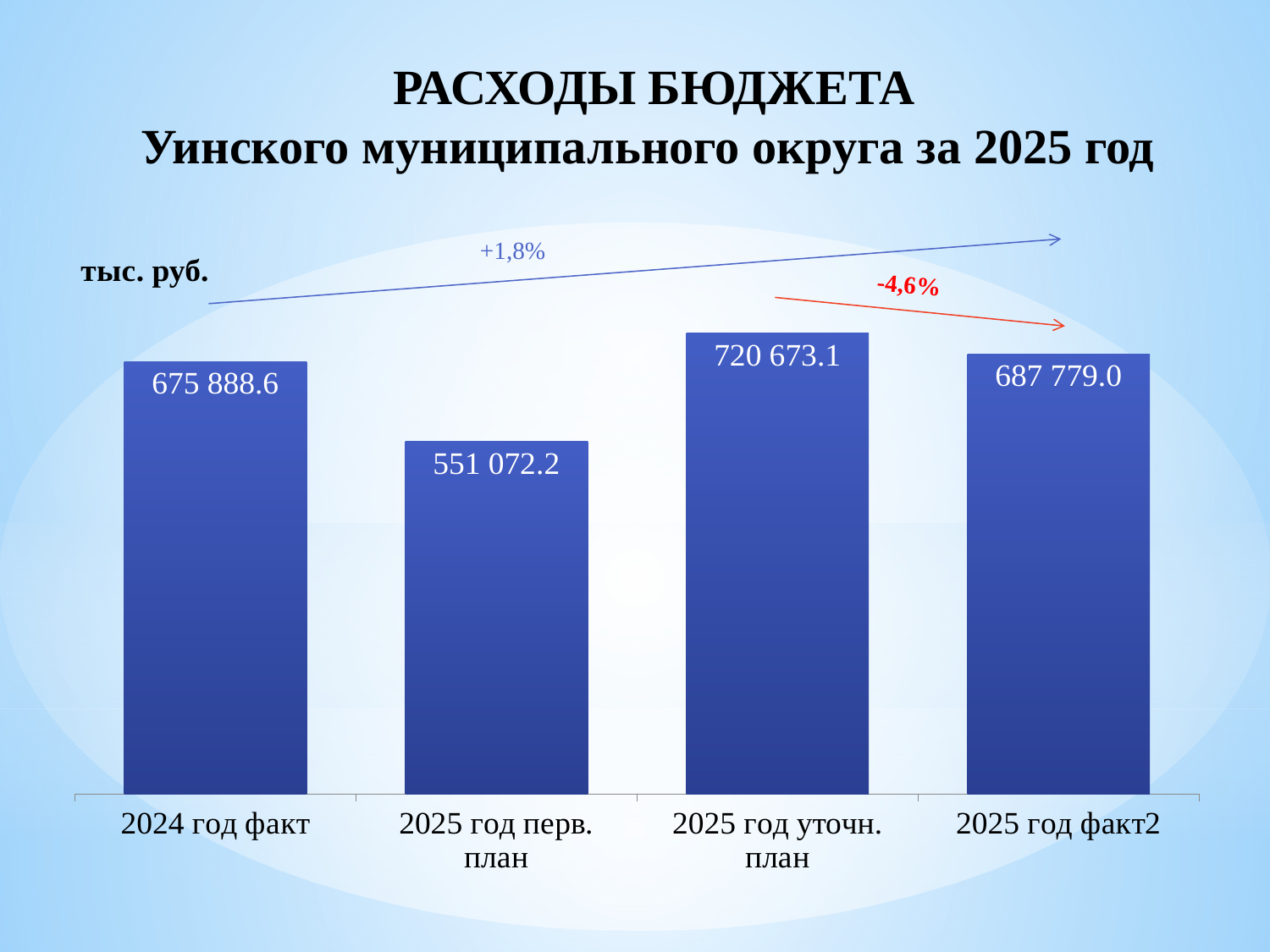
Which is larger, the value for 2024 год факт or the value for 2025 год факт2? 2025 год факт2 What unit of measurement is indicated for the chart values? тыс. руб. Which category has the lowest value? 2025 год перв. план What is the difference between the values for 2025 год уточн. план and 2025 год факт2? 32 894.1 How many categories are shown in the chart? 4 What is the value for 2025 год уточн. план? 720 673.1 What is the difference between the values for 2024 год факт and 2025 год перв. план? 124 816.4 What kind of chart is shown on the slide? bar chart What is the value for 2025 год перв. план? 551 072.2 What is the value for 2024 год факт? 675 888.6 What is the value for 2025 год факт2? 687 779.0 Which category has the highest value? 2025 год уточн. план